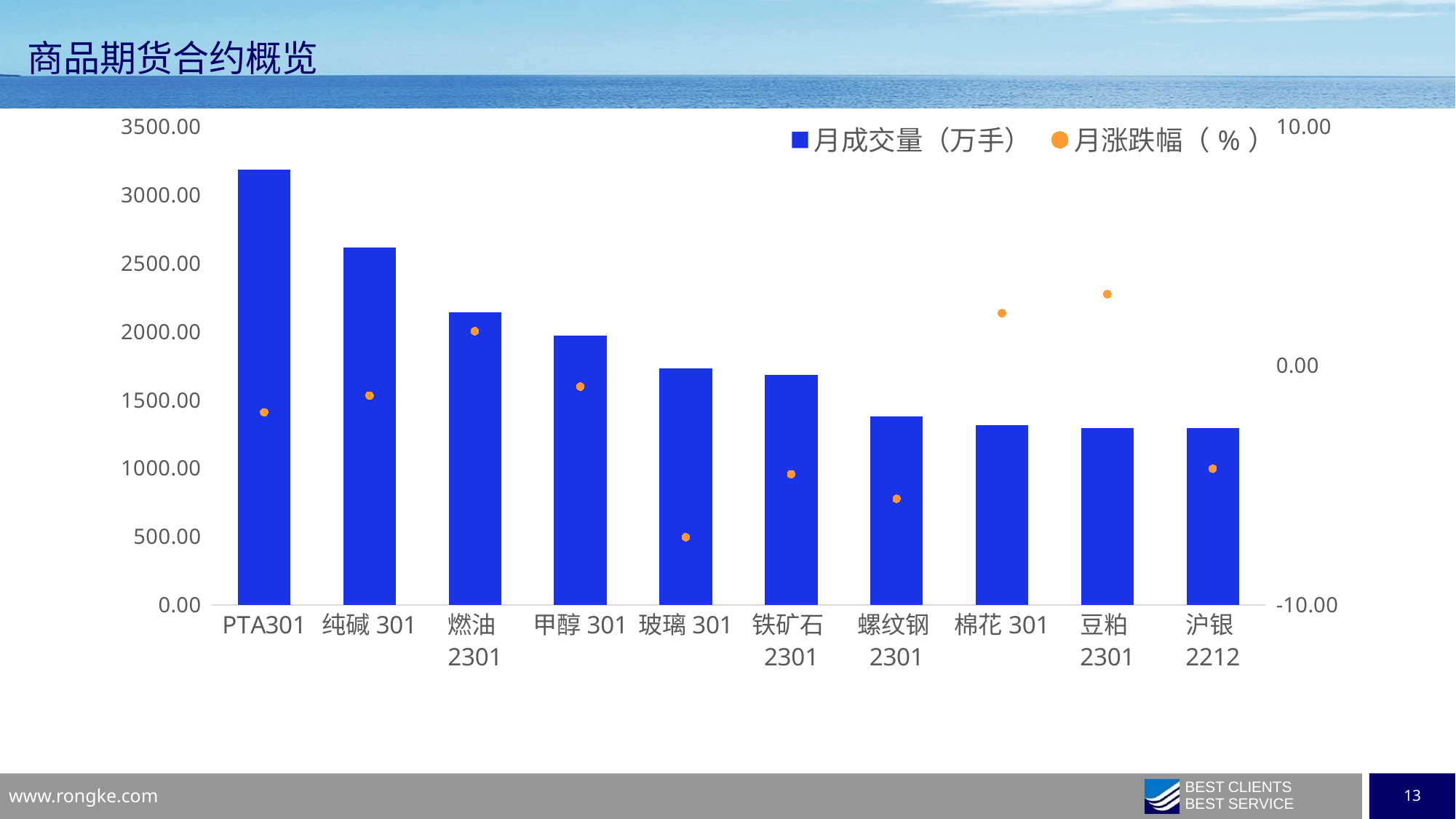
Which contract has the lowest 月涨跌幅（%）? 玻璃 301 How many contracts are shown along the x axis? 10 Which has a larger 月成交量（万手）, 燃油 2301 or 螺纹钢 2301? 燃油 2301 Is the 月成交量（万手） for 螺纹钢 2301 greater or less than 1500? less Do the 月成交量（万手） bars rise or fall from left to right along the x axis? fall Is the 月成交量（万手） for PTA301 greater or less than 3000? greater Which contract has the highest 月成交量（万手）? PTA301 Is the 月涨跌幅（%） for 棉花 301 greater or less than 0.00? greater What are the two series named in the legend? 月成交量（万手） and 月涨跌幅（%） How many series does the legend list? 2 Which contract has the highest 月涨跌幅（%）? 豆粕 2301 What kind of chart is shown on the slide? A bar chart combined with a dot (scatter) series